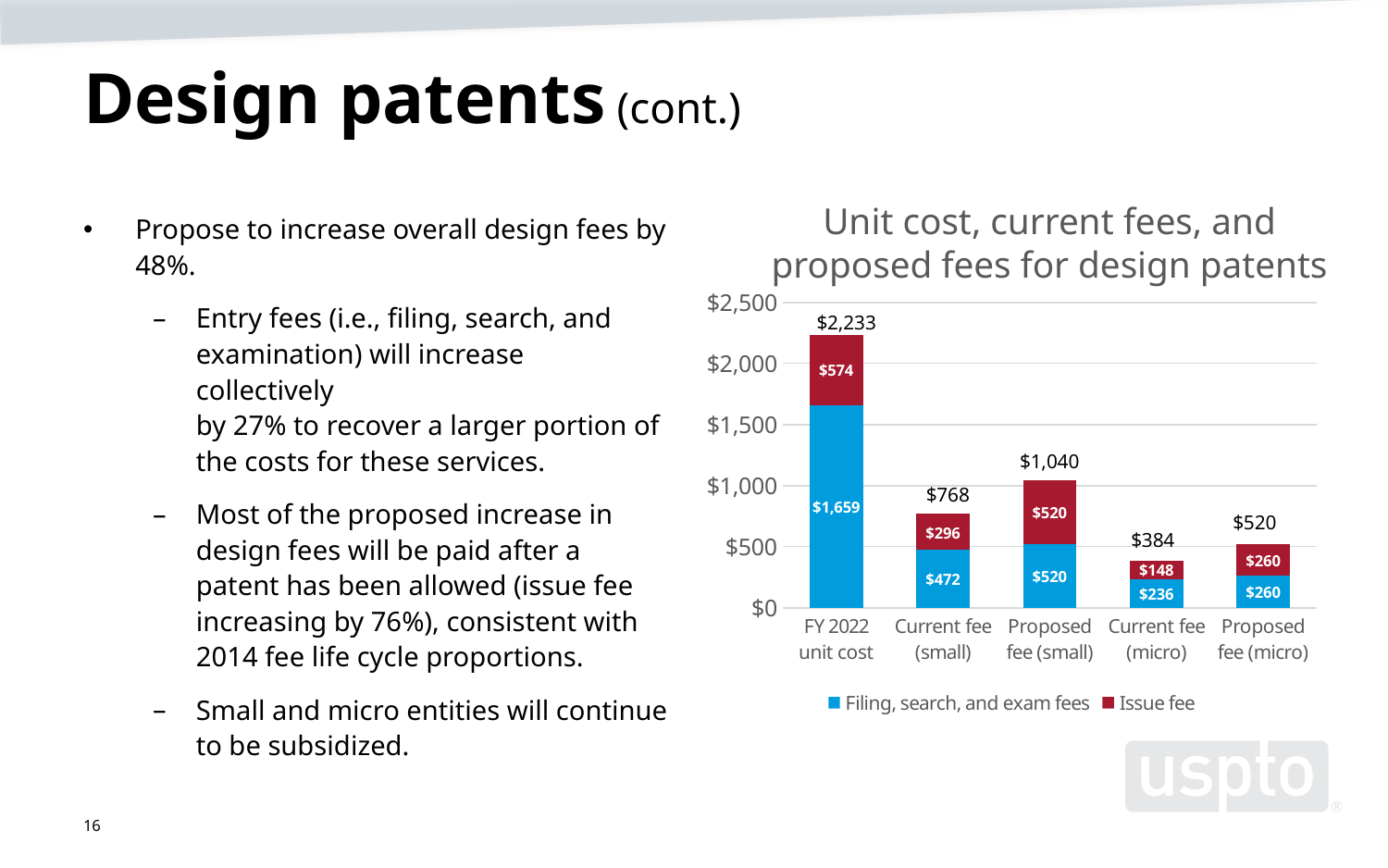
What is the difference between the totals for Proposed fee (small) and Current fee (small)? $272 What is the Issue fee value for FY 2022 unit cost? $574 How many series does the legend list? 2 Which category has the highest total? FY 2022 unit cost Which is larger, the Issue fee for Current fee (small) or the Issue fee for Proposed fee (small)? Proposed fee (small) How many categories are shown on the x axis? 5 What is the Filing, search, and exam fees value for Current fee (small)? $472 What is the total of the stacked bar for Current fee (micro)? $384 What type of chart is shown? Stacked bar chart What is the Issue fee value for Proposed fee (micro)? $260 Which category has the lowest total? Current fee (micro) What is the total of the stacked bar for Proposed fee (small)? $1,040